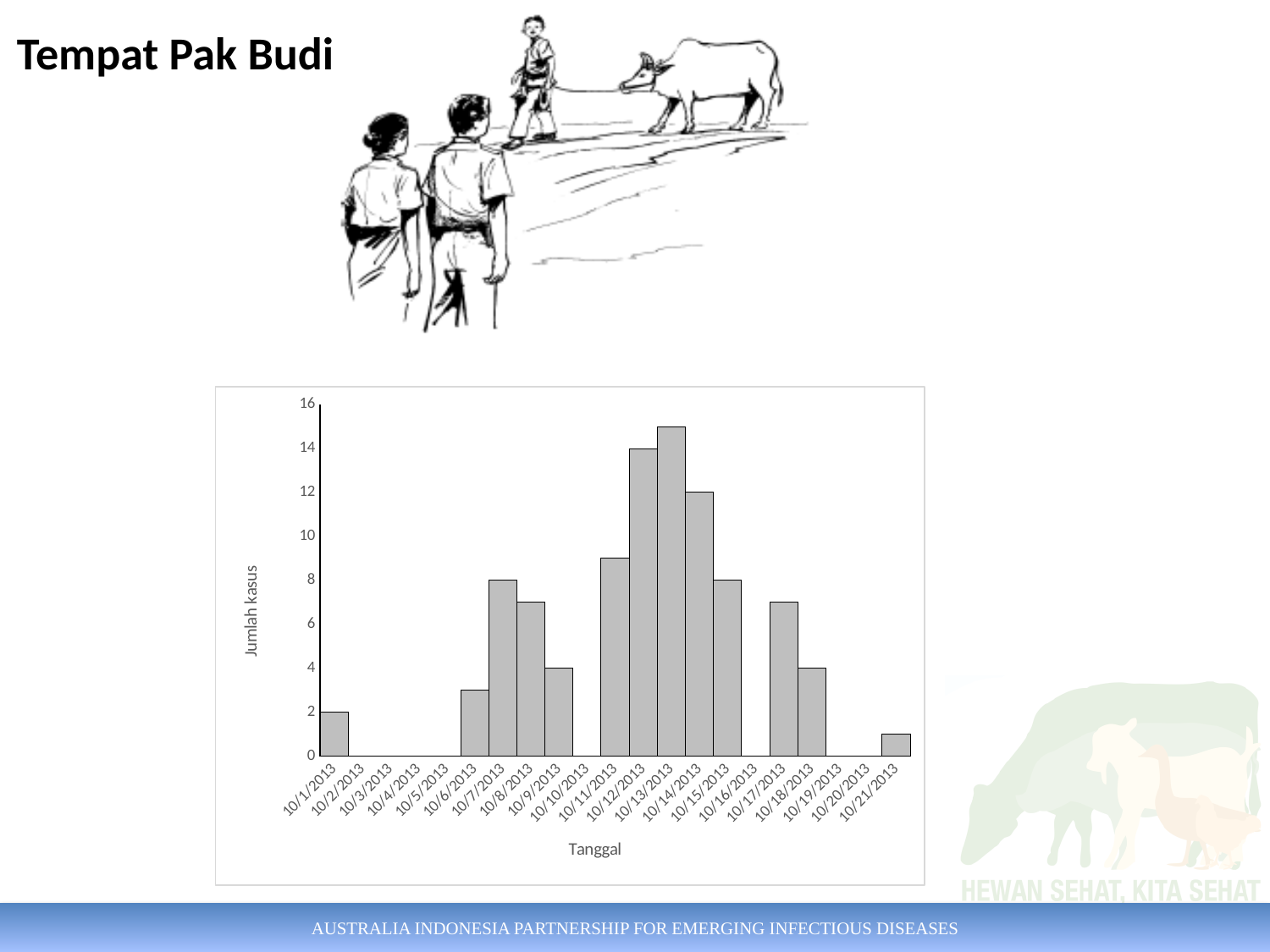
Is the number of cases on 10/13/2013 greater or less than 14? greater What is the label of the horizontal axis of the chart? Tanggal What kind of chart is shown on the slide? bar chart What is the number of cases on 10/14/2013? 12 What is the label of the vertical axis of the chart? Jumlah kasus What is the difference in the number of cases between 10/14/2013 and 10/15/2013? 4 How many dates are shown along the x axis of the chart? 21 Is the number of cases on 10/21/2013 greater or less than 2? less Which date has the highest number of cases in the chart? 10/13/2013 What is the number of cases on 10/12/2013? 14 Which date has more cases, 10/7/2013 or 10/9/2013? 10/7/2013 What is the number of cases on 10/1/2013? 2